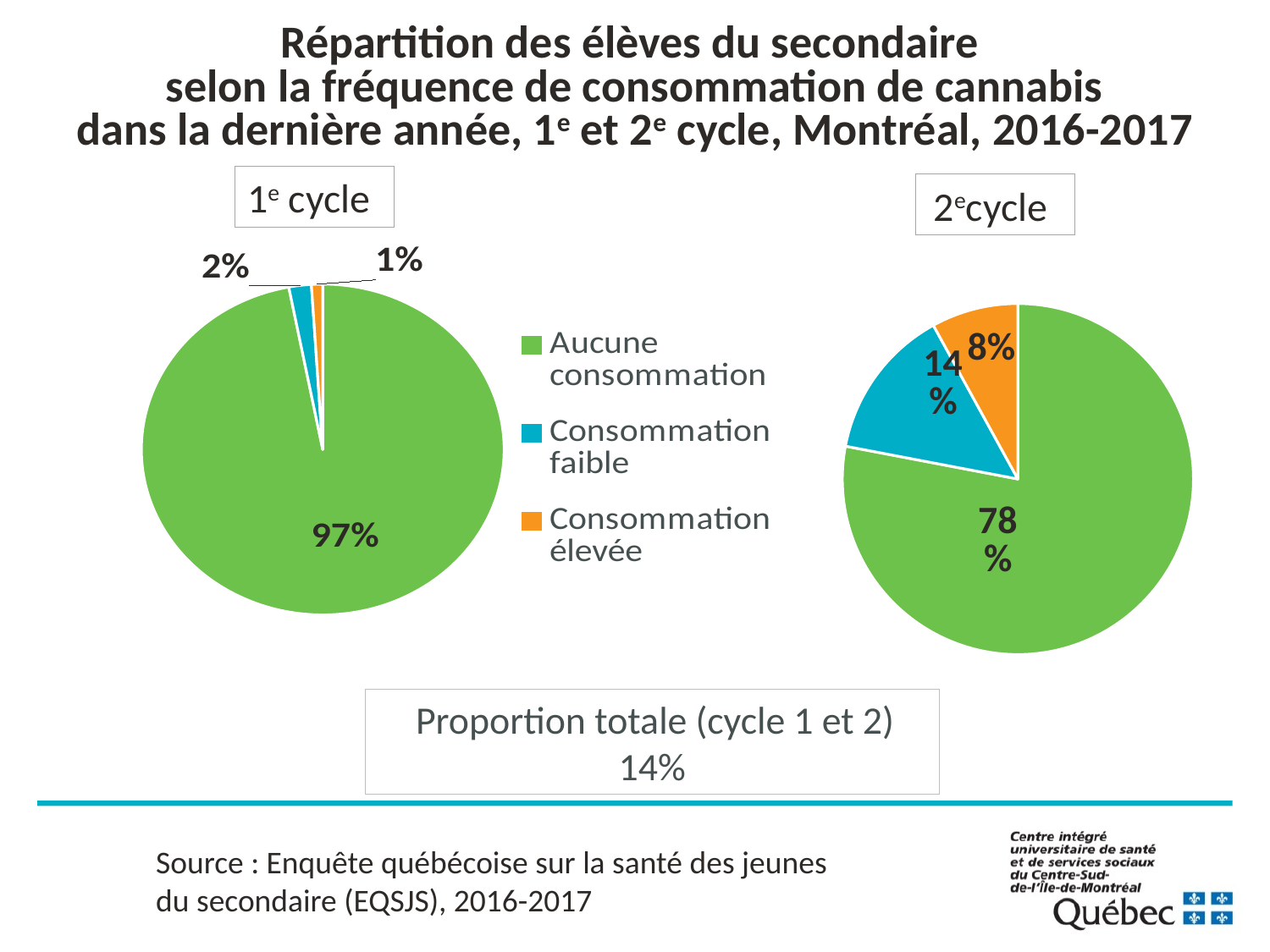
In the 2e cycle pie chart, what share of students had high consumption (Consommation élevée)? 8% In the 1e cycle pie chart, which category has the smallest slice? Consommation élevée In the 1e cycle pie chart, what share of students had low consumption (Consommation faible)? 2% Which is larger: the Consommation faible share in the 2e cycle chart or the Consommation faible share in the 1e cycle chart? 2e cycle What is the difference between the share of students with no consumption in the 1e cycle chart and in the 2e cycle chart? 19 percentage points In the 2e cycle pie chart, which category has the largest slice? Aucune consommation In the 2e cycle pie chart, what share of students had low consumption (Consommation faible)? 14% In the 1e cycle pie chart, what share of students had no cannabis consumption (Aucune consommation)? 97% In the 1e cycle pie chart, what share of students had high consumption (Consommation élevée)? 1% How many categories does the legend list? 3 What type of chart is used on this slide? Pie chart In the 2e cycle pie chart, what share of students had no cannabis consumption (Aucune consommation)? 78%